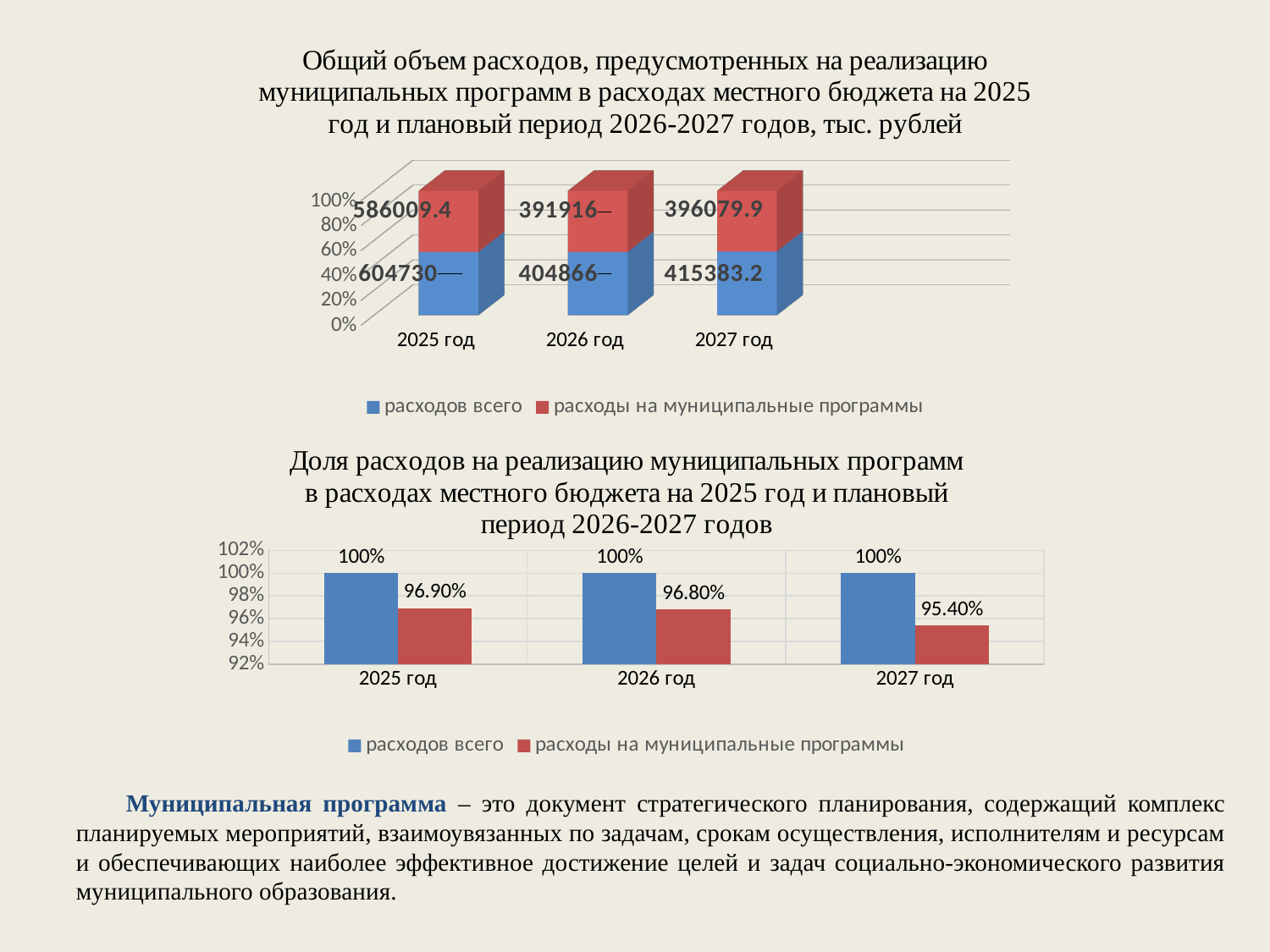
In the bottom chart (Доля расходов...), what is the difference between 'расходов всего' and 'расходы на муниципальные программы' for 2027 год? 4.60% In the top chart (Общий объем расходов...), what is the difference between 'расходов всего' and 'расходы на муниципальные программы' for 2025 год? 18720.6 In the top chart (Общий объем расходов...), what is the difference between 'расходов всего' and 'расходы на муниципальные программы' for 2026 год? 12950 In the top chart (Общий объем расходов...), how many series does the legend list? 2 What kind of chart is the bottom chart (Доля расходов...)? bar chart In the top chart (Общий объем расходов...), what is the value of 'расходы на муниципальные программы' for 2027 год? 396079.9 In the bottom chart (Доля расходов...), which year has the lowest value of 'расходы на муниципальные программы'? 2027 год In the bottom chart (Доля расходов...), do the values of 'расходы на муниципальные программы' rise or fall from 2025 год to 2027 год? fall In the top chart (Общий объем расходов...), which year has the highest value of 'расходов всего'? 2025 год In the top chart (Общий объем расходов...), what is the value of 'расходы на муниципальные программы' for 2026 год? 391916 In the top chart (Общий объем расходов...), what is the value of 'расходов всего' for 2025 год? 604730 In the bottom chart (Доля расходов...), what is the value of 'расходы на муниципальные программы' for 2026 год? 96.80%